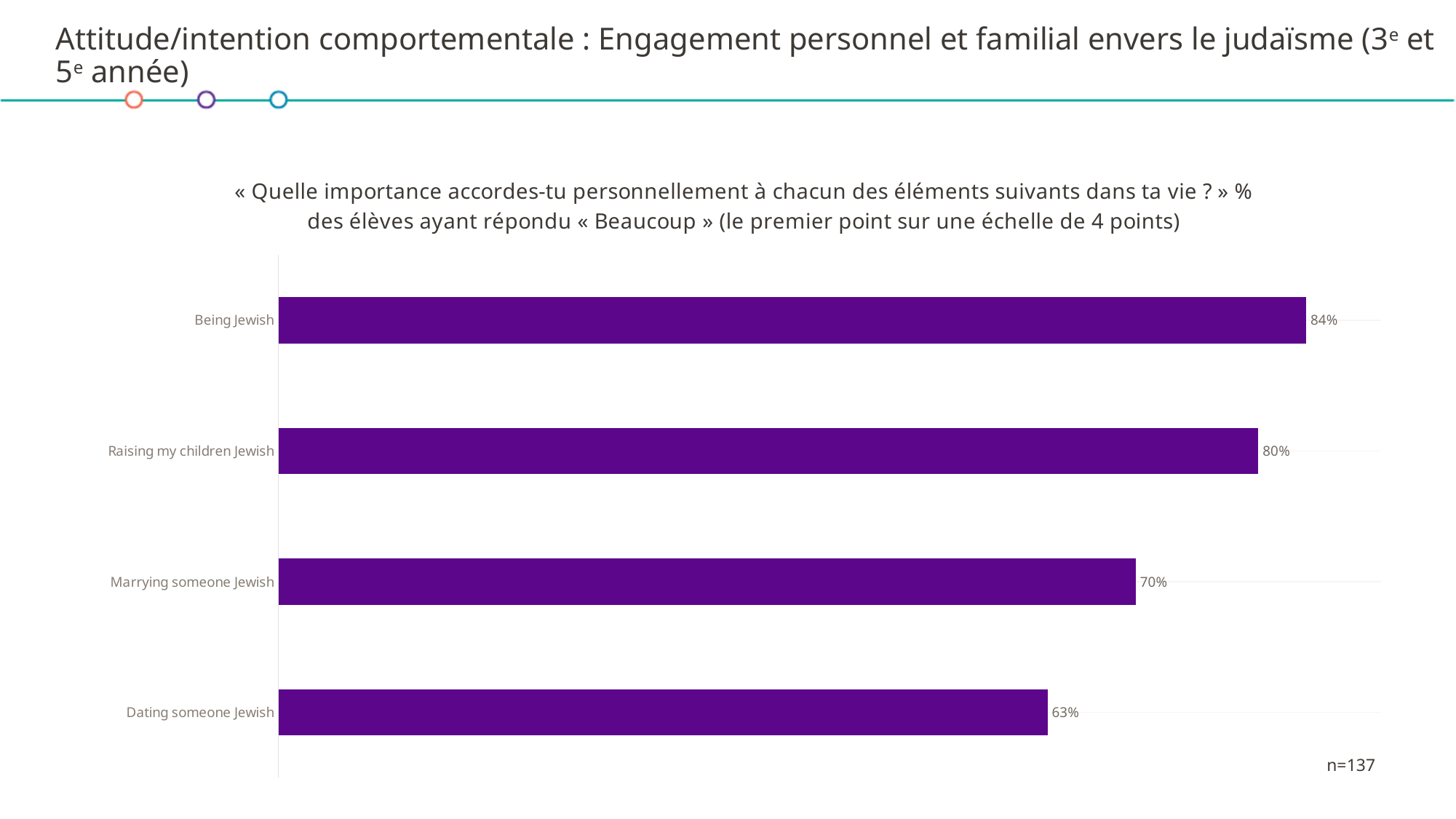
How many categories are shown in the chart? 4 What kind of chart is shown on the slide? Bar chart Which is larger, the value for Marrying someone Jewish or the value for Dating someone Jewish? Marrying someone Jewish What is the value for Raising my children Jewish? 80% Which category has the highest value? Being Jewish What is the value for Being Jewish? 84% What is the difference between the values for Raising my children Jewish and Marrying someone Jewish? 10% What is the difference between the values for Being Jewish and Dating someone Jewish? 21% Which category has the lowest value? Dating someone Jewish What is the value for Dating someone Jewish? 63% What sample size (n) is shown on the chart? n=137 What is the value for Marrying someone Jewish? 70%